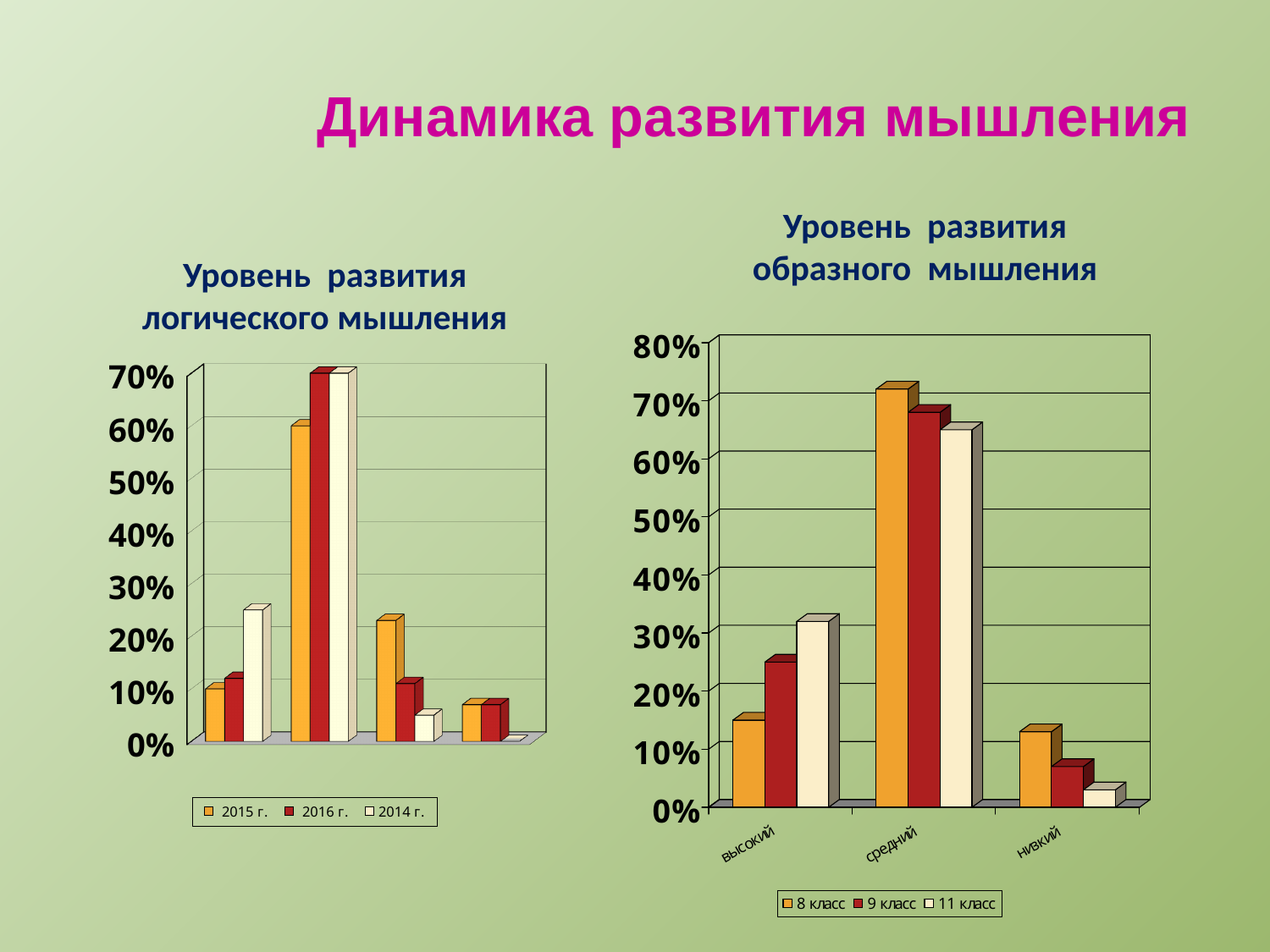
How many series does the legend of the chart "Уровень развития логического мышления" list? 3 How many categories are shown on the x axis of the chart "Уровень развития образного мышления"? 3 What are the legend entries of the chart "Уровень развития логического мышления"? 2015 г., 2016 г., 2014 г. In the chart "Уровень развития образного мышления", which is larger in the низкий category: 8 класс or 9 класс? 8 класс In the chart "Уровень развития образного мышления", is the value for 11 класс in the низкий category greater or less than 10%? less In the chart "Уровень развития образного мышления", is the value for 8 класс in the средний category greater or less than 70%? greater In the chart "Уровень развития образного мышления", is the value for 11 класс in the средний category greater or less than 70%? less In the chart "Уровень развития образного мышления", which category has the highest value for 8 класс? средний How many series does the legend of the chart "Уровень развития образного мышления" list? 3 What kind of chart is the chart titled "Уровень развития образного мышления"? bar chart In the chart "Уровень развития образного мышления", which is larger in the высокий category: 9 класс or 11 класс? 11 класс